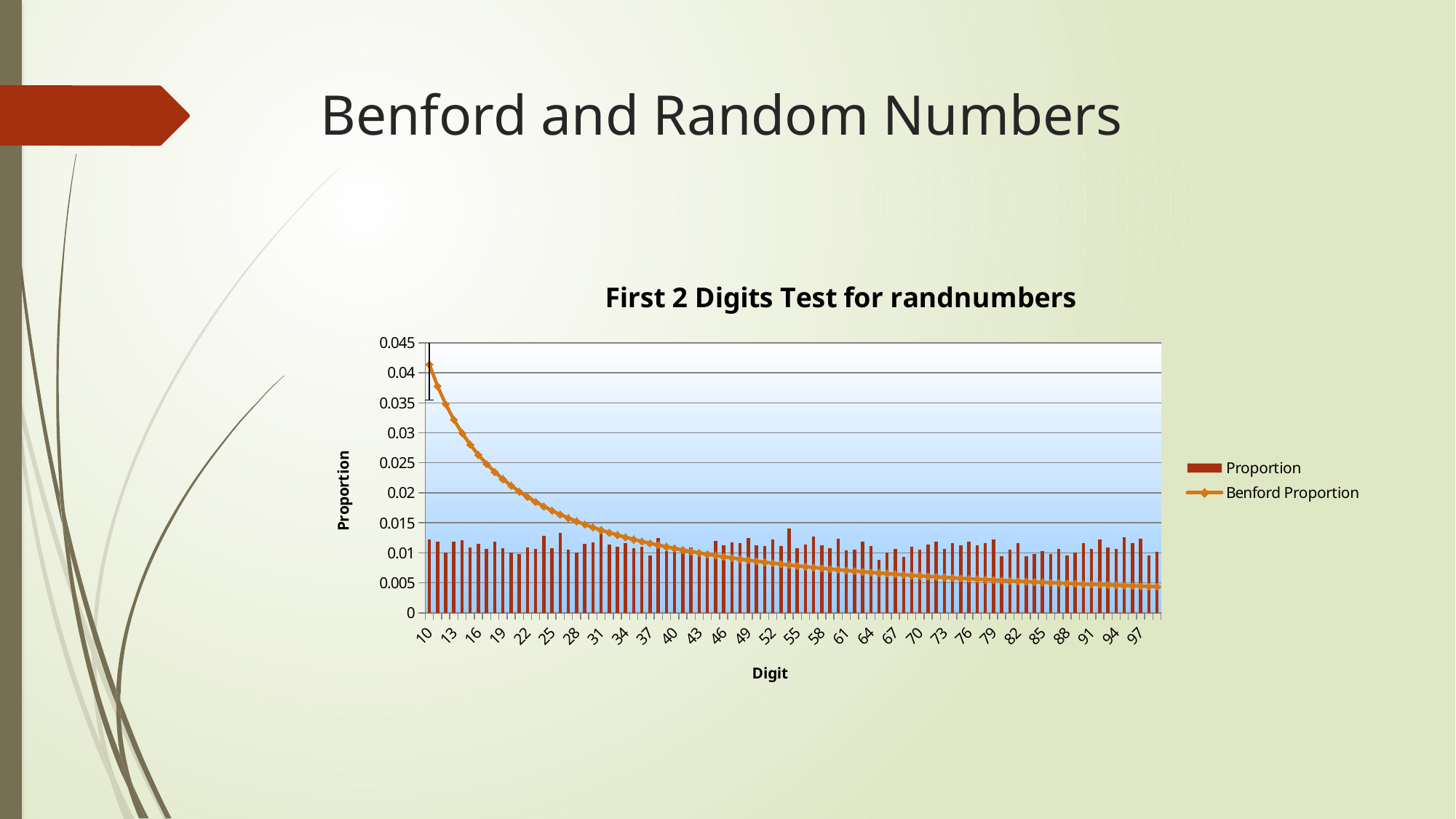
What is the label of the x axis? Digit At digit 97, which is larger: the Proportion bar or the Benford Proportion line? Proportion How many series does the chart legend list? 2 Is the Benford Proportion value at digit 13 greater or less than 0.03? greater Does the Benford Proportion line rise or fall as the digit increases along the x axis? Fall At which digit is the Benford Proportion line highest? 10 At digit 10, which is larger: the Proportion bar or the Benford Proportion line? Benford Proportion Is the Benford Proportion value at digit 34 greater or less than 0.015? less Is the Benford Proportion value at digit 70 greater or less than 0.01? less What is the title of the chart? First 2 Digits Test for randnumbers What kind of chart is used to plot the Proportion series? Bar chart